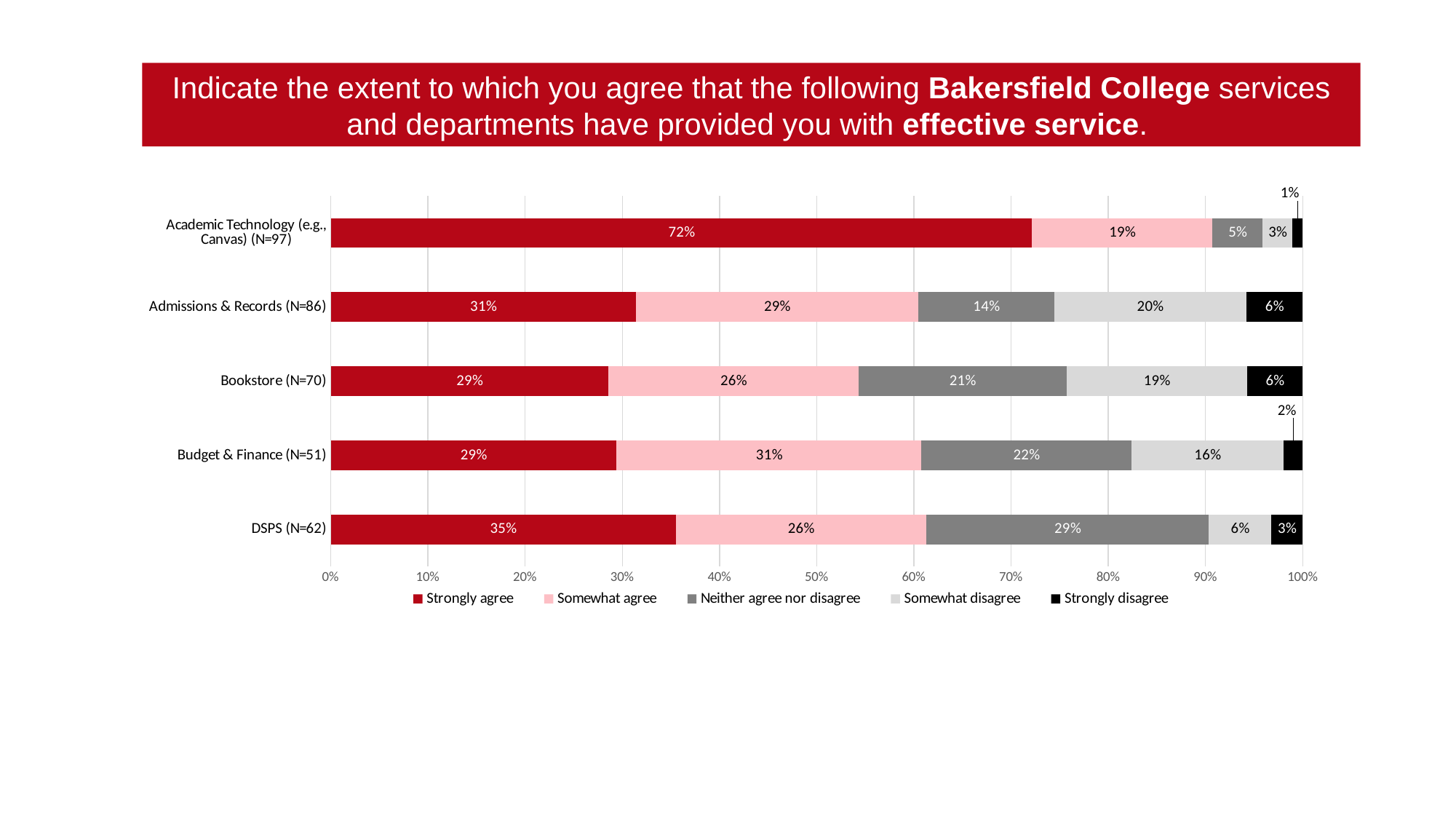
Which legend entry is shown in black? Strongly disagree Which department has the highest 'Strongly agree' percentage? Academic Technology (e.g., Canvas) (N=97) What is the 'Somewhat disagree' value for Admissions & Records (N=86)? 20% What is the 'Strongly disagree' value for Budget & Finance (N=51)? 2% What kind of chart is shown on the slide? Stacked bar chart What is the difference between the 'Strongly agree' percentages for DSPS (N=62) and Bookstore (N=70)? 6% How many series does the legend list? 5 How many departments or services are shown in the chart? 5 Which department has the lowest 'Strongly disagree' percentage? Academic Technology (e.g., Canvas) (N=97) What is the 'Neither agree nor disagree' value for DSPS (N=62)? 29% What percentage of respondents strongly agree that Academic Technology (e.g., Canvas) provided effective service? 72% Which is larger: the 'Somewhat agree' value for Budget & Finance (N=51) or for Bookstore (N=70)? Budget & Finance (N=51)